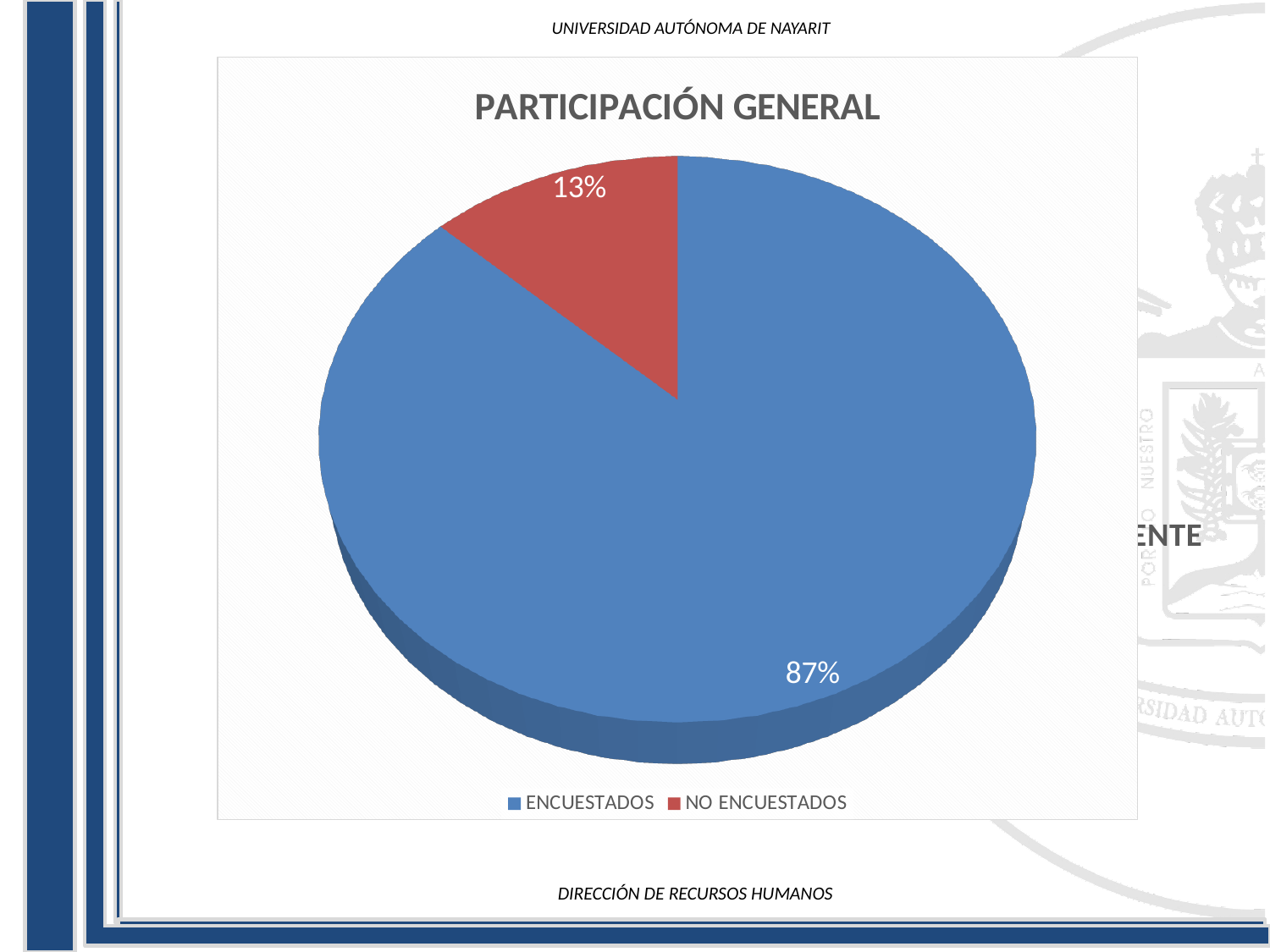
Which category has the largest slice of the pie? ENCUESTADOS Which category has the smallest slice of the pie? NO ENCUESTADOS What share of the pie is ENCUESTADOS? 87% What share of the pie is NO ENCUESTADOS? 13% What is the title of the chart? PARTICIPACIÓN GENERAL Which colour represents NO ENCUESTADOS in the chart? red What kind of chart is shown on the slide? pie chart How many slices does the pie chart have? 2 How many entries does the legend list? 2 What is the difference in percentage points between ENCUESTADOS and NO ENCUESTADOS? 74 Which is larger, the ENCUESTADOS slice or the NO ENCUESTADOS slice? ENCUESTADOS